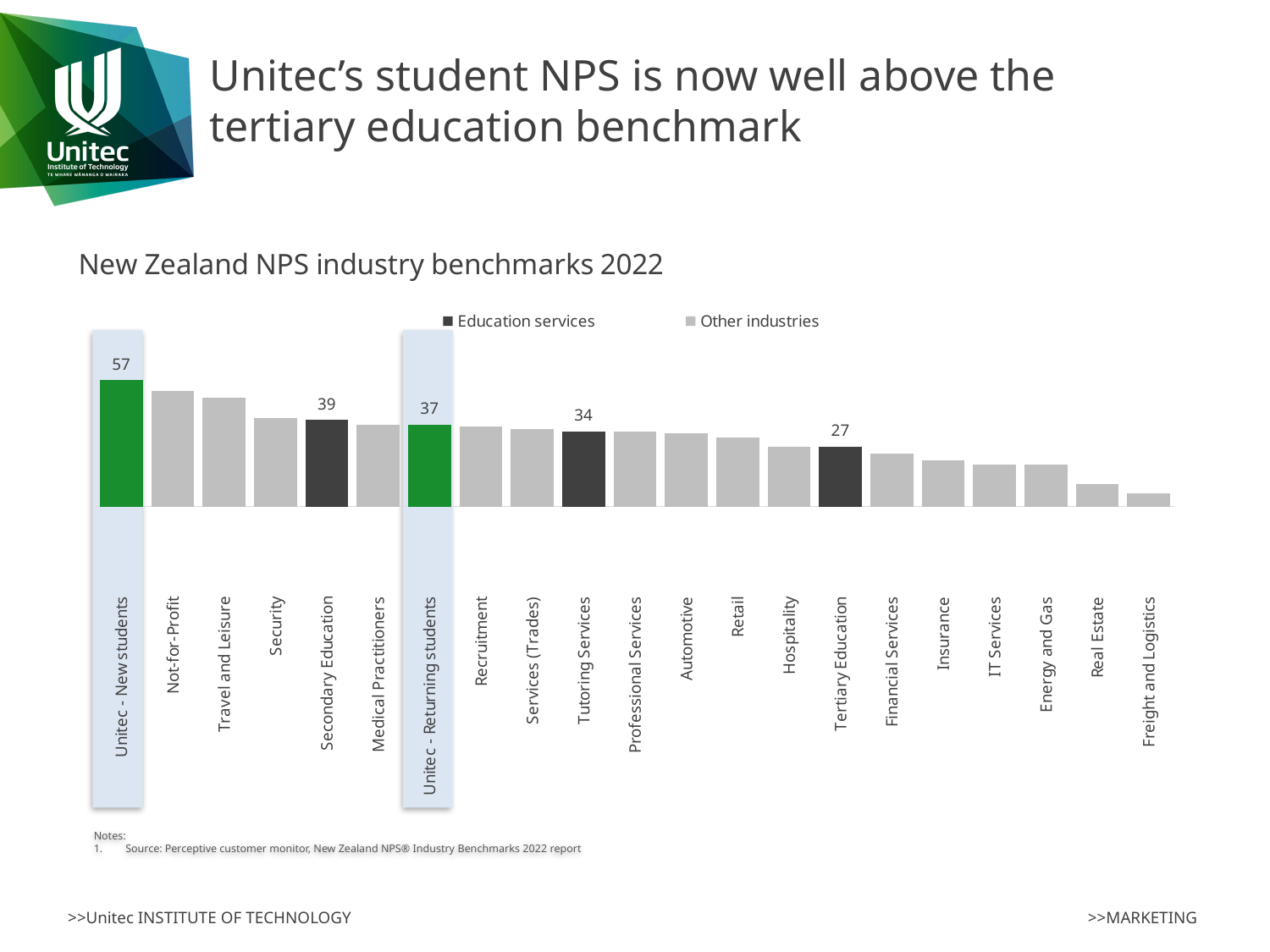
Which category has the lowest NPS in the chart? Freight and Logistics What is the difference between the NPS for Unitec - Returning students and Tertiary Education? 10 How many categories are shown in the chart? 21 What is the NPS value for Unitec - Returning students? 37 What is the NPS value for Unitec - New students? 57 What is the NPS value for Tertiary Education? 27 How many series does the legend list? 2 Which category has the highest NPS in the chart? Unitec - New students Which has a higher NPS, Secondary Education or Unitec - Returning students? Secondary Education What is the NPS value for Tutoring Services? 34 How much higher is the NPS for Unitec - New students than for Tertiary Education? 30 What is the NPS value for Secondary Education? 39